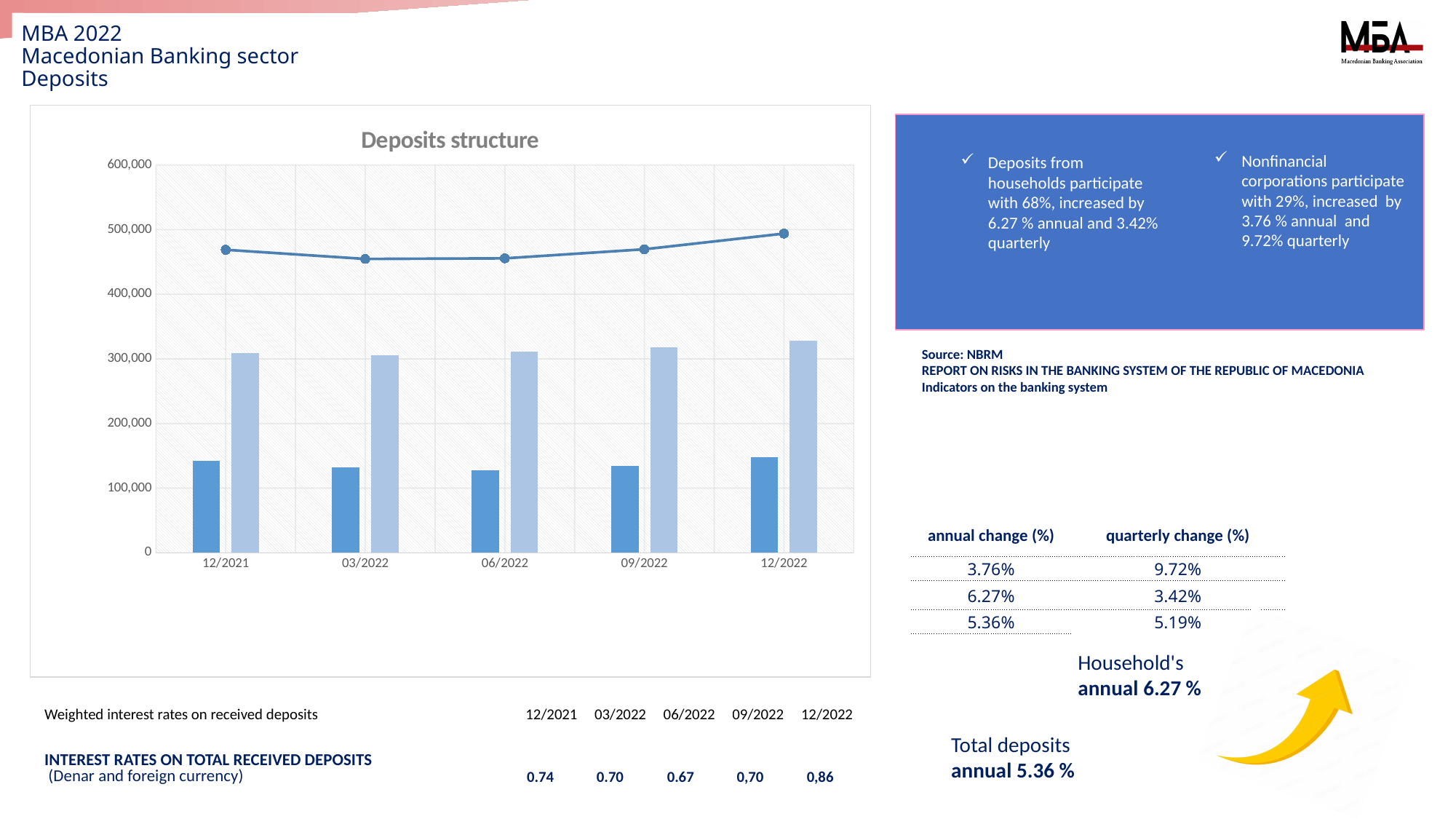
How many time periods are shown on the x axis of the Deposits structure chart? 5 In the Deposits structure chart, for which period is the light blue bar the highest? 12/2022 In the Deposits structure chart, is the dark blue bar for 12/2022 greater or less than 100,000? greater In the Deposits structure chart, is the dark blue bar for 06/2022 greater or less than 200,000? less What is the title of the chart on the slide? Deposits structure In the Deposits structure chart, is the line value for 03/2022 greater or less than 400,000? greater In the Deposits structure chart, which bar is larger for 09/2022, the dark blue bar or the light blue bar? the light blue bar In the Deposits structure chart, do the light blue bars rise or fall from 03/2022 to 12/2022? rise In the Deposits structure chart, for which period does the line reach its highest point? 12/2022 What kind of chart is the Deposits structure chart? bar chart with a line